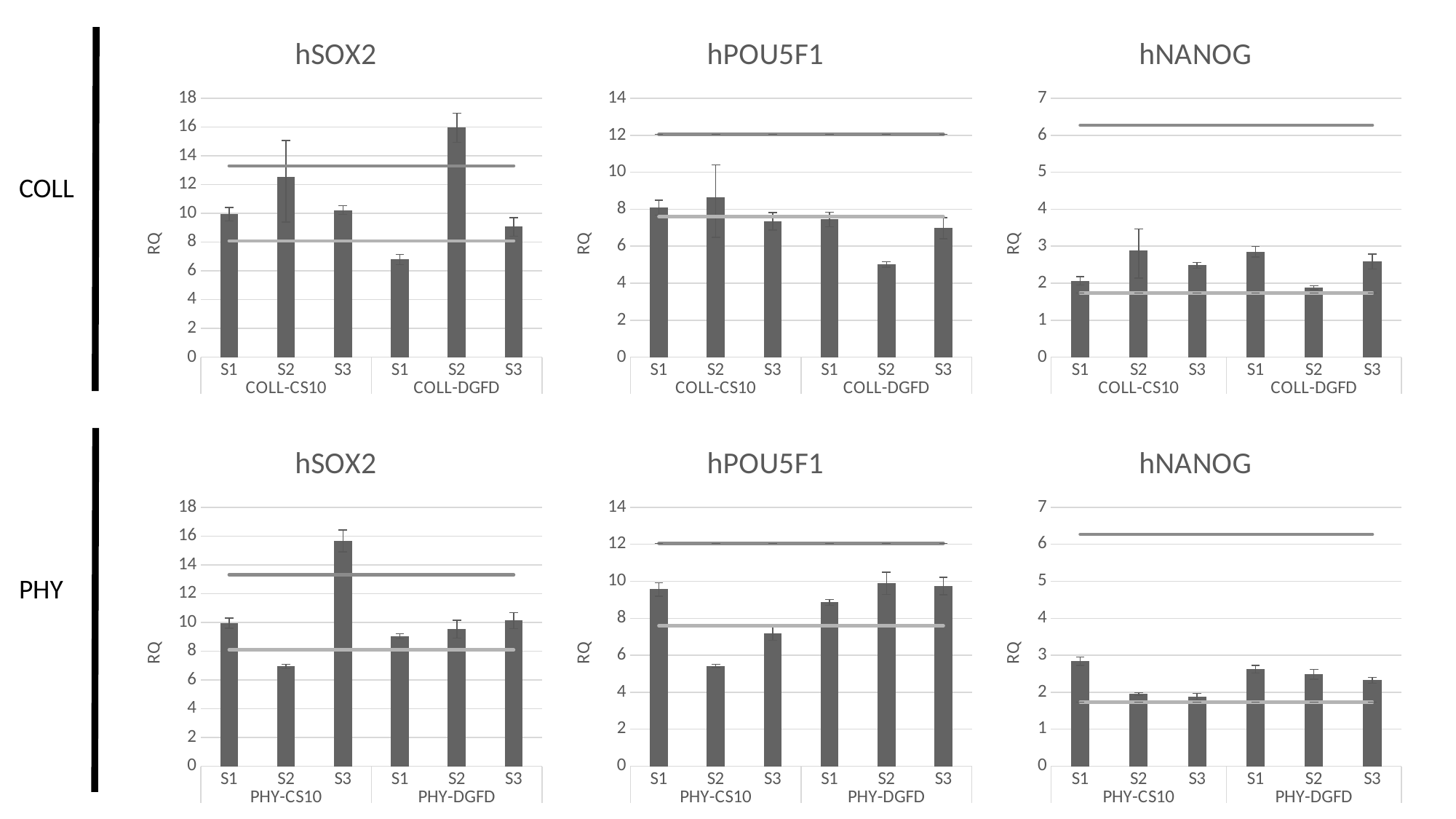
In the top-right hNANOG chart (COLL row), which bar is the lowest? COLL-DGFD S2 In the bottom-middle hPOU5F1 chart (PHY row), which is larger, PHY-CS10 S1 or PHY-CS10 S3? PHY-CS10 S1 In the top-middle hPOU5F1 chart (COLL row), which bar is the lowest? COLL-DGFD S2 In the top-left hSOX2 chart (COLL row), which bar is the highest? COLL-DGFD S2 How many bars are plotted in the bottom-right hNANOG chart (PHY row)? 6 In the bottom-left hSOX2 chart (PHY row), which bar is the highest? PHY-CS10 S3 In the bottom-right hNANOG chart (PHY row), which bar is the highest? PHY-CS10 S1 In the top-left hSOX2 chart (COLL row), which bar is the lowest? COLL-DGFD S1 In the top-middle hPOU5F1 chart (COLL row), is the value for COLL-DGFD S2 greater or less than 6? less In the top-left hSOX2 chart (COLL row), is the value for COLL-DGFD S2 greater or less than 14? greater